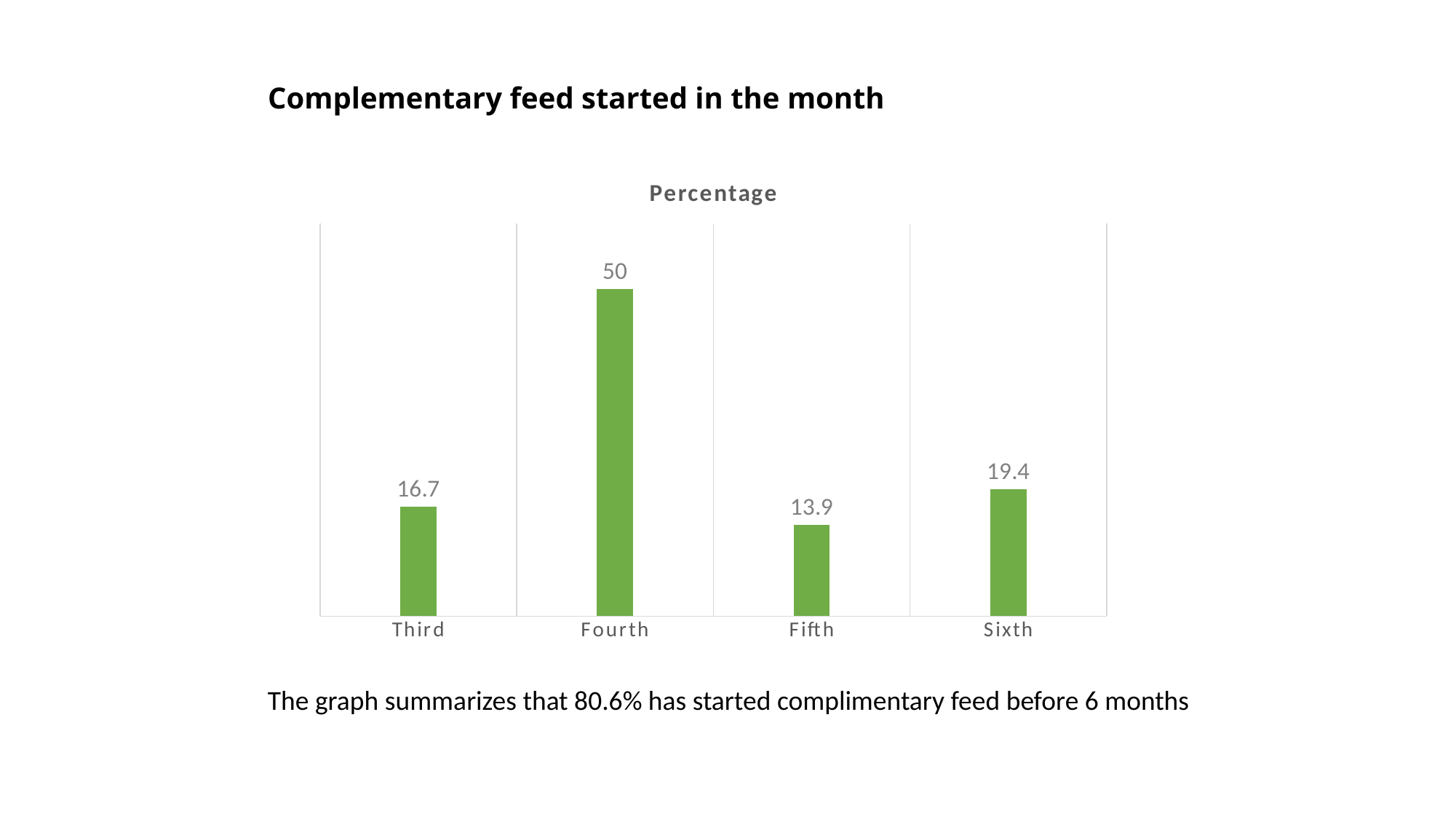
What is the percentage for the Sixth month? 19.4 Which month has the lowest percentage? Fifth What is the difference between the percentages for the Fourth and Sixth months? 30.6 Which month has the highest percentage? Fourth What is the percentage for the Third month? 16.7 What kind of chart is shown on the slide? Bar chart Which has a larger percentage, the Third month or the Sixth month? Sixth How many months are shown on the x axis of the chart? 4 What is the percentage for the Fifth month? 13.9 What is the difference between the percentages for the Third and Fifth months? 2.8 What is the title of the chart? Percentage What is the percentage for the Fourth month? 50